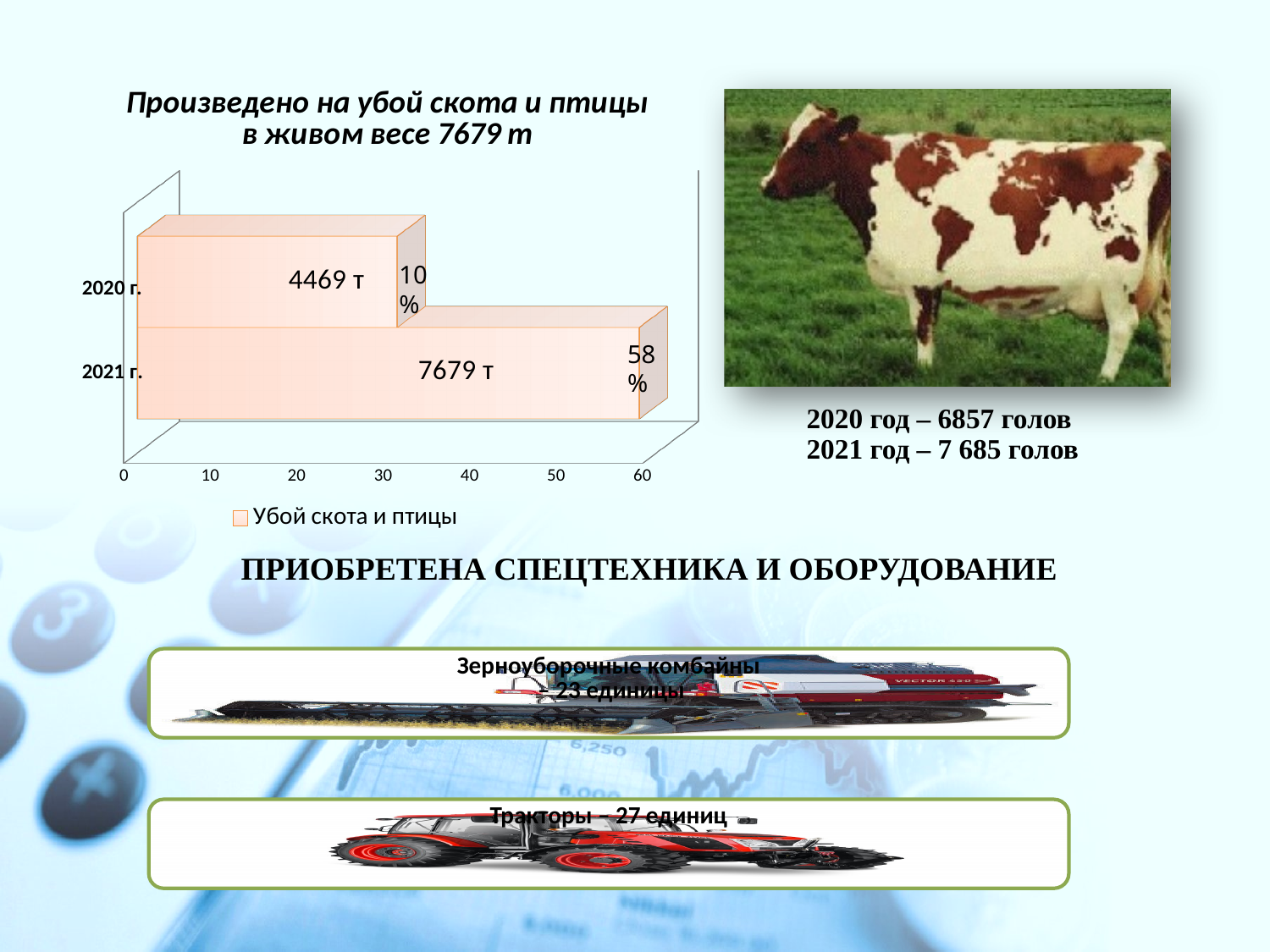
Which year has the higher value in the chart? 2021 г. What is the value labelled on the bar for 2020 г.? 4469 т What is the difference between the labelled values for 2021 г. and 2020 г.? 3210 т Is the labelled value for 2021 г. larger or smaller than the value for 2020 г.? larger What is the value labelled on the bar for 2021 г.? 7679 т How many categories (years) are plotted in the chart? 2 What kind of chart is shown on the slide? bar chart Which year has the lower value in the chart? 2020 г. On the horizontal axis, is the bar for 2020 г. greater or less than 40? less On the horizontal axis, does the bar for 2021 г. extend beyond 50? yes What is the legend entry of the chart? Убой скота и птицы How many series does the chart legend list? 1